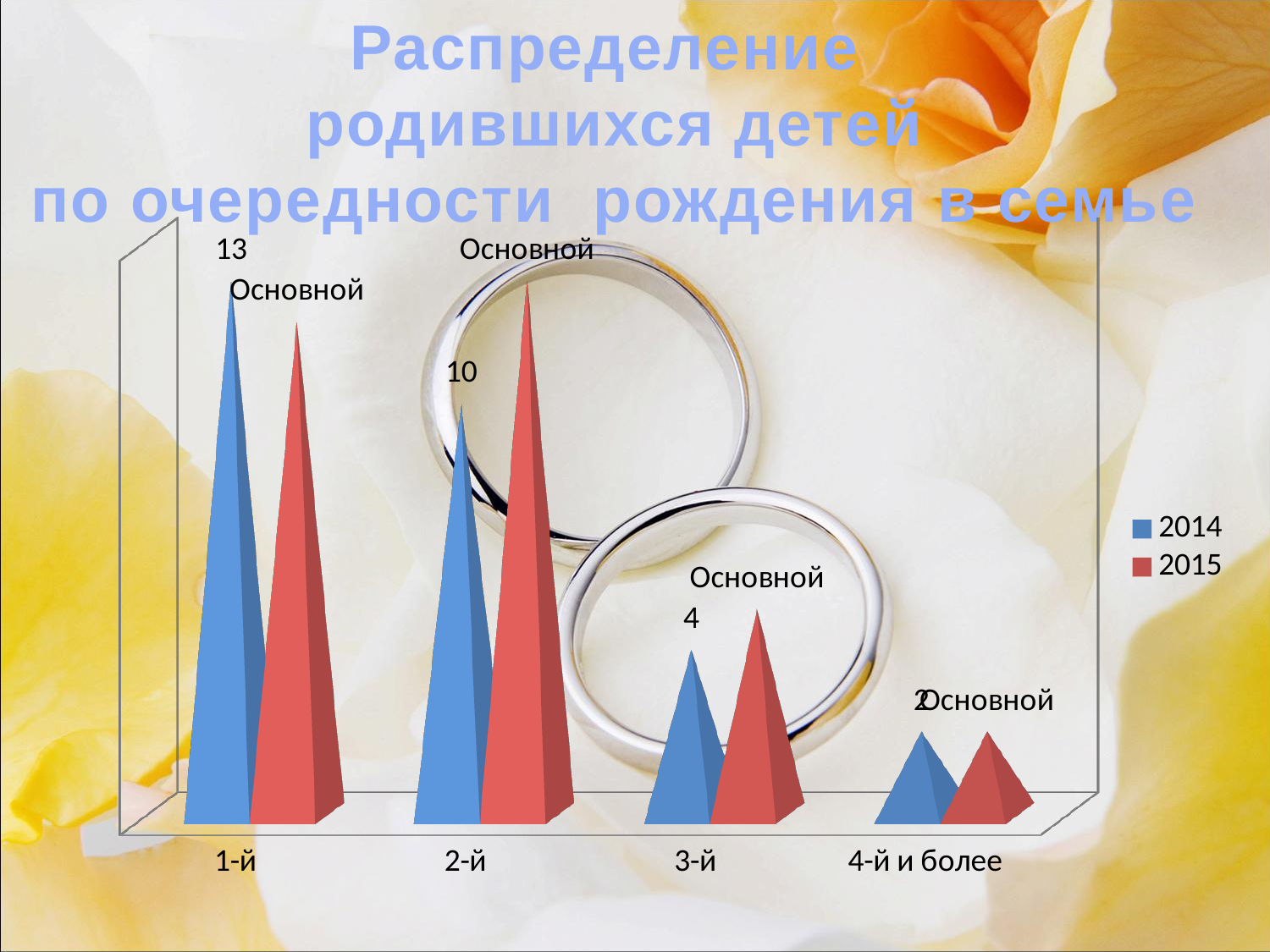
What is the difference between the 2014 values for 1-й and 2-й? 3 What is the difference between the 2014 values for 2-й and 3-й? 6 Which category has the lowest value for the 2014 series? 4-й и более What is the value for 2014 in the 2-й category? 10 What is the value for 2014 in the 1-й category? 13 In the 1-й category, which series has the larger value, 2014 or 2015? 2014 How many categories are shown on the x axis? 4 What is the value for 2014 in the 4-й и более category? 2 In the 2-й category, which series has the larger value, 2014 or 2015? 2015 How many series does the legend list? 2 Which category has the highest value for the 2014 series? 1-й What is the value for 2014 in the 3-й category? 4